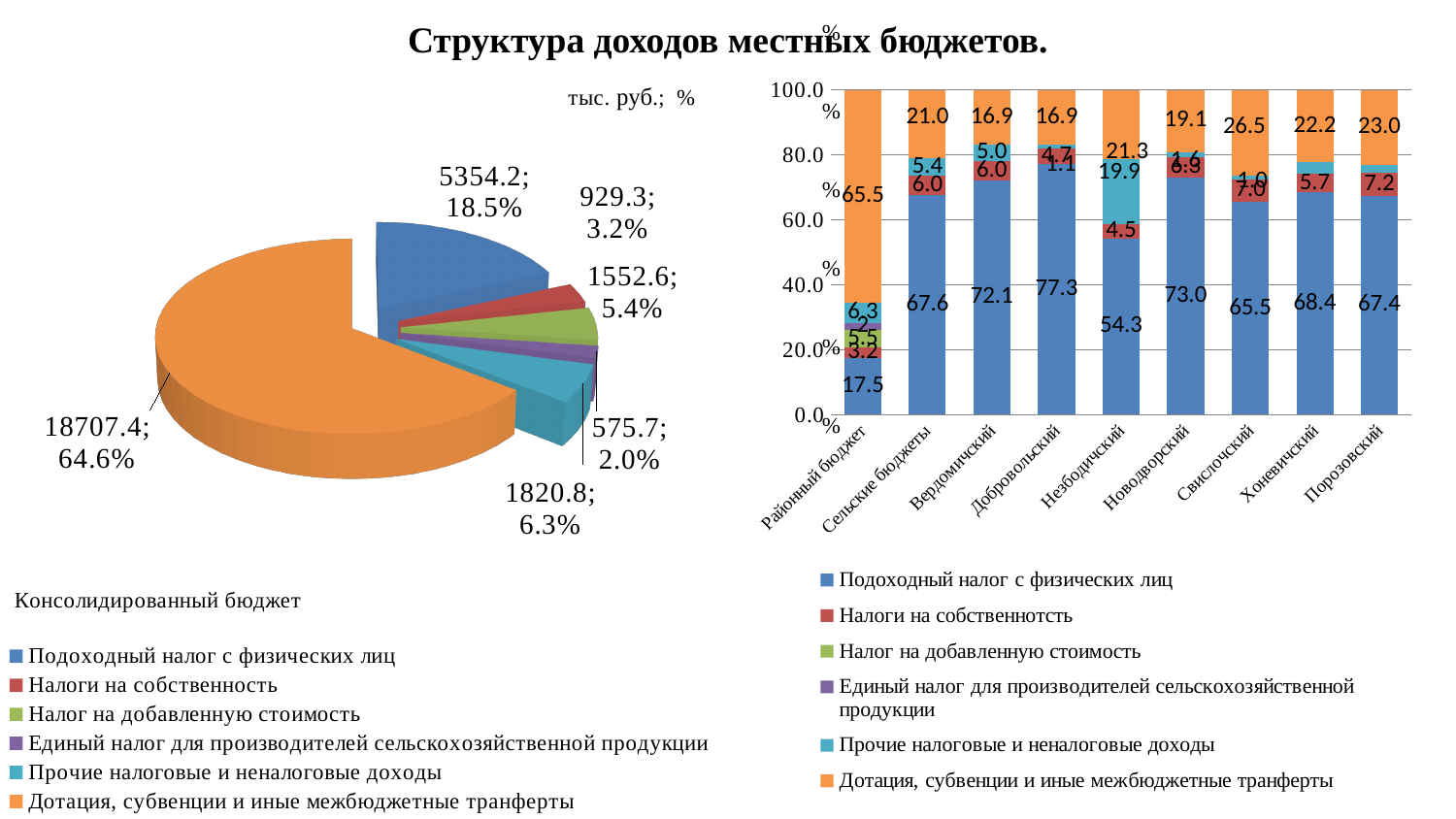
On the stacked bar chart on the right, what is the value of Подоходный налог с физических лиц for Добровольский? 77.3 On the pie chart (Консолидированный бюджет), what share does Подоходный налог с физических лиц have? 18.5% On the stacked bar chart on the right, what is the value of Дотация, субвенции и иные межбюджетные трансферты for Районный бюджет? 65.5 On the stacked bar chart on the right, which category has the lowest value for Подоходный налог с физических лиц? Районный бюджет On the pie chart (Консолидированный бюджет), what value is shown for Дотация, субвенции и иные межбюджетные трансферты? 18707.4; 64.6% On the stacked bar chart on the right, what is the difference between the Подоходный налог с физических лиц values for Вердомичский and Незбодичский? 17.8 On the pie chart (Консолидированный бюджет), which category has the smallest slice? Единый налог для производителей сельскохозяйственной продукции On the stacked bar chart on the right, which category has the highest value for Подоходный налог с физических лиц? Добровольский What type of chart is on the left side of the slide? Pie chart On the stacked bar chart on the right, how many categories are shown on the x axis? 9 On the pie chart (Консолидированный бюджет), what is the value for Прочие налоговые и неналоговые доходы? 1820.8; 6.3% On the stacked bar chart on the right, how many series does the legend list? 6